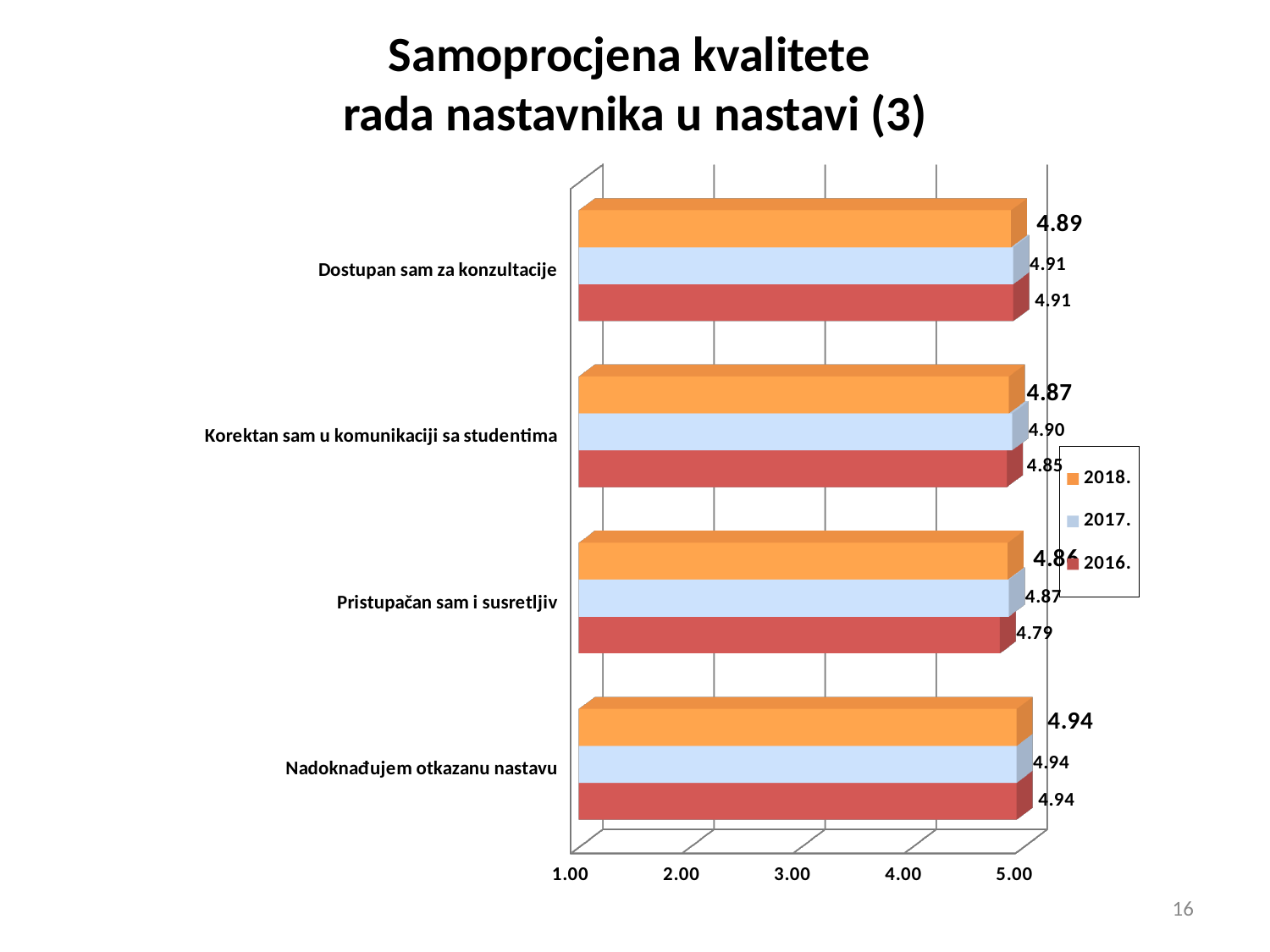
What is the difference between the 2017. and 2016. values for "Pristupačan sam i susretljiv"? 0.08 What kind of chart is shown on the slide? bar chart What is the 2018. value for "Nadoknađujem otkazanu nastavu"? 4.94 What is the 2016. value for "Pristupačan sam i susretljiv"? 4.79 How many categories are shown on the chart? 4 What is the 2018. value for "Dostupan sam za konzultacije"? 4.89 Which category has the highest 2018. value? Nadoknađujem otkazanu nastavu For "Korektan sam u komunikaciji sa studentima", which is larger: the 2017. value or the 2016. value? 2017. How many series does the legend list? 3 What is the 2017. value for "Korektan sam u komunikaciji sa studentima"? 4.90 Which series is shown in orange in the legend? 2018. Which category has the lowest 2016. value? Pristupačan sam i susretljiv